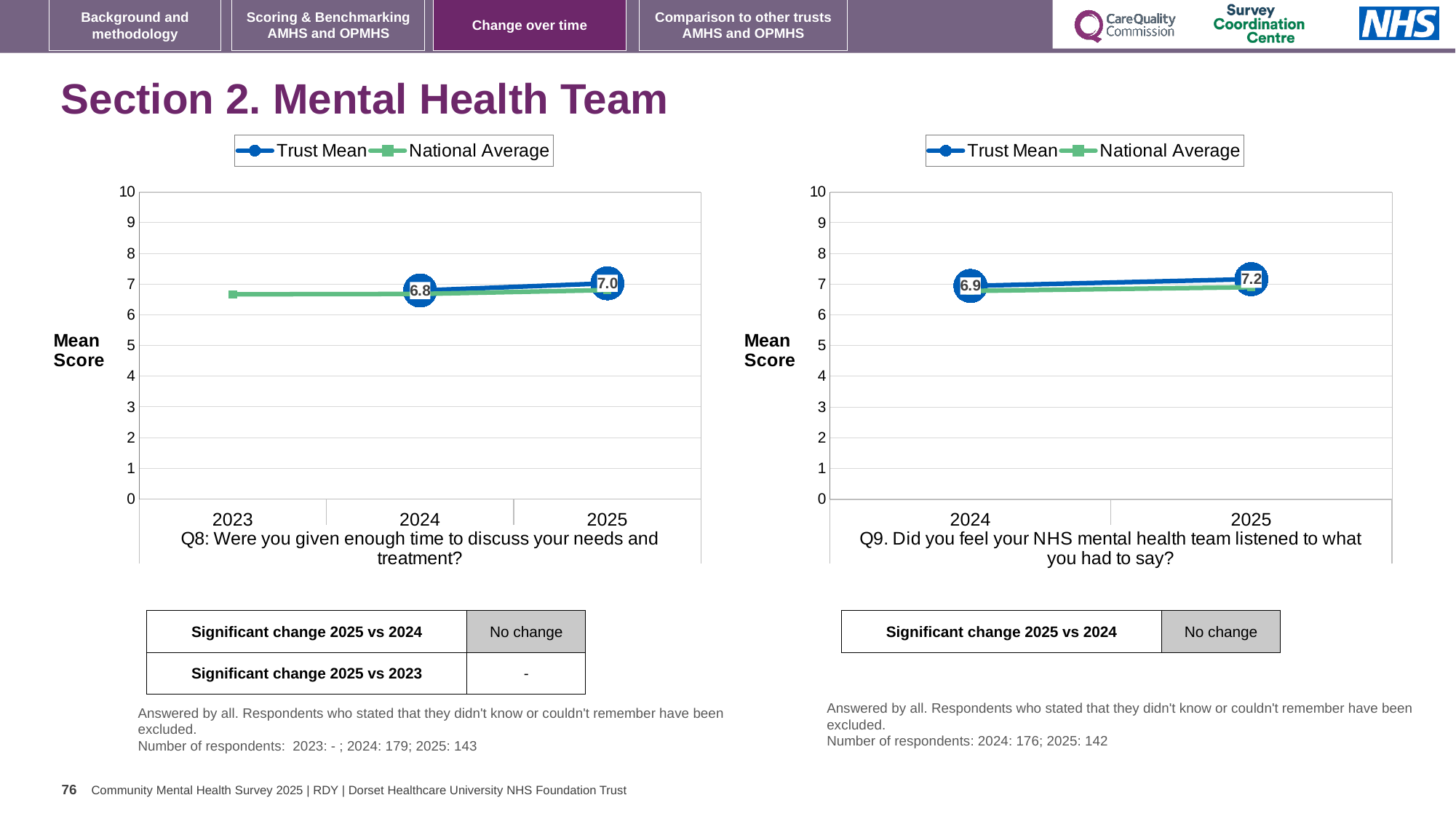
In the left chart (Q8), by how much did the Trust Mean change from 2024 to 2025? 0.2 In the right chart (Q9), what is the difference between the Trust Mean in 2025 and in 2024? 0.3 Which series is shown in green in the right chart (Q9)? National Average What type of chart is used on the left for Q8? line chart How many years are shown on the x axis of the left chart (Q8)? 3 In the right chart (Q9), what is the Trust Mean for 2025? 7.2 In the right chart (Q9), what is the Trust Mean for 2024? 6.9 In the left chart (Q8), what is the Trust Mean for 2025? 7.0 How many series does the legend of the right chart (Q9) list? 2 In the left chart (Q8), what is the Trust Mean for 2024? 6.8 In the left chart (Q8), is the National Average for 2023 greater or less than 5? greater In the right chart (Q9), does the Trust Mean rise or fall from 2024 to 2025? rise